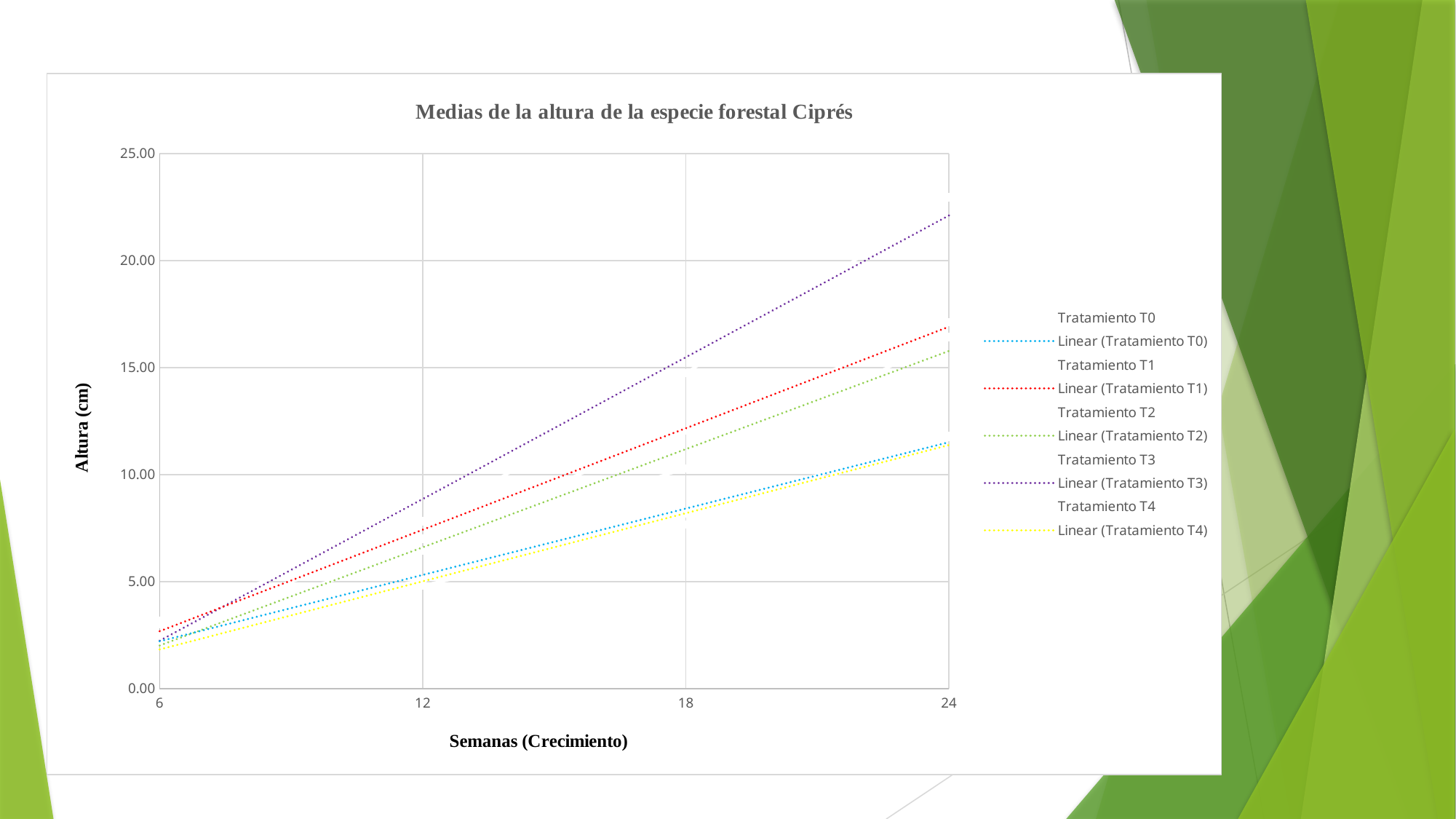
Which treatment's trend line reaches the highest height at week 24? Tratamiento T3 How many tick values are shown on the x axis (Semanas)? 4 Is the value of the Linear (Tratamiento T1) line at week 24 greater or less than 15.00? greater At week 24, which is higher: the Linear (Tratamiento T3) line or the Linear (Tratamiento T1) line? Linear (Tratamiento T3) Is the value of the Linear (Tratamiento T4) line at week 12 greater or less than 10.00? less How many entries does the chart legend list? 10 Is the value of the Linear (Tratamiento T0) line at week 24 greater or less than 15.00? less Do the trend lines rise or fall as the weeks increase along the x axis? rise What is the title of the chart? Medias de la altura de la especie forestal Ciprés What kind of chart is shown on the slide? line chart What is the label of the vertical axis? Altura (cm)